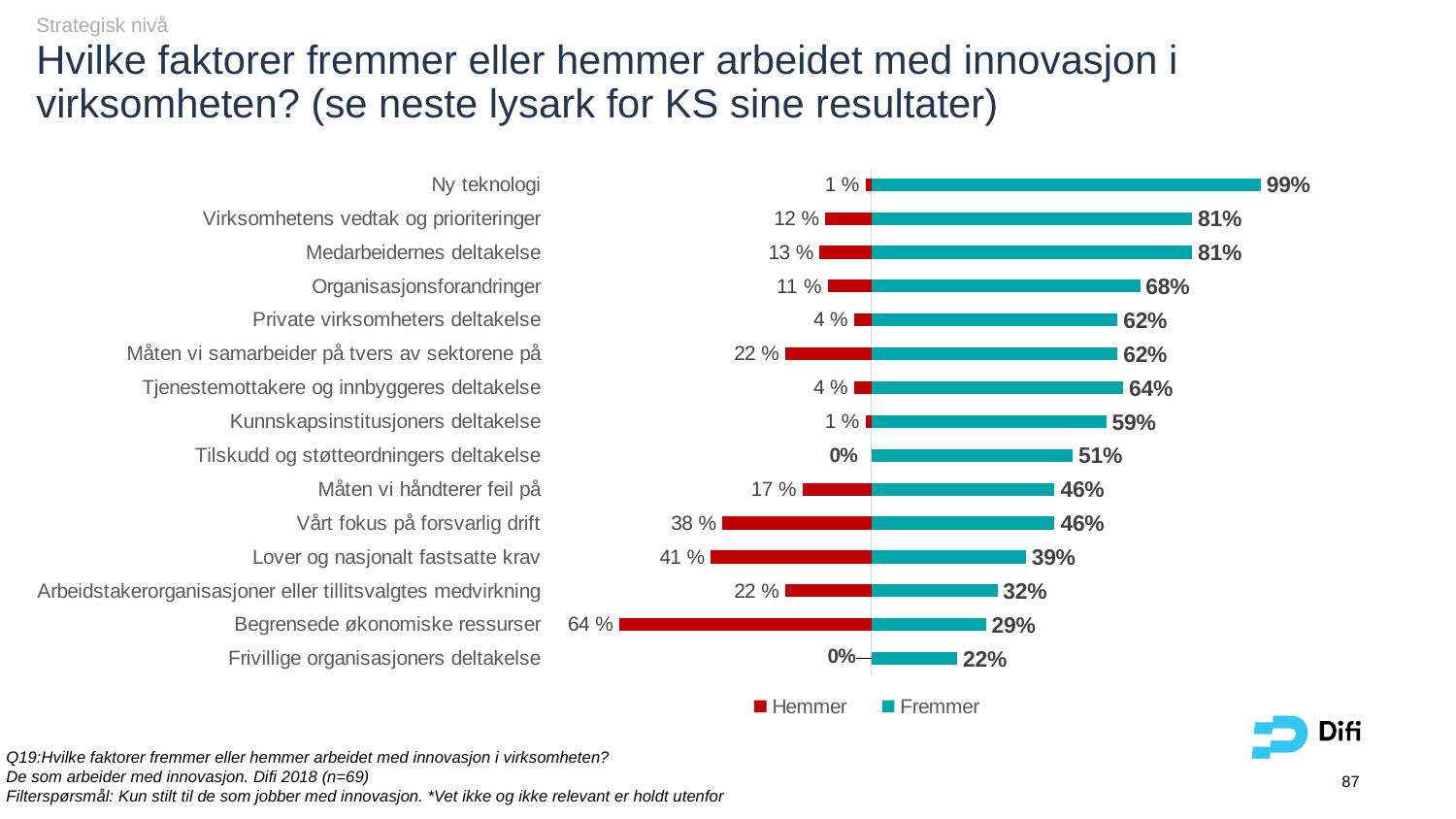
What kind of chart is shown on the slide? Bar chart What is the Hemmer value for Begrensede økonomiske ressurser? 64 % What is the Fremmer value for Ny teknologi? 99% Which category has the highest Hemmer value? Begrensede økonomiske ressurser What is the Fremmer value for Lover og nasjonalt fastsatte krav? 39% How many series does the legend list? 2 Which category has the lowest Fremmer value? Frivillige organisasjoners deltakelse Which category has the highest Fremmer value? Ny teknologi For Lover og nasjonalt fastsatte krav, which is larger: the Hemmer value or the Fremmer value? Hemmer How many categories are shown in the chart? 15 What is the Hemmer value for Vårt fokus på forsvarlig drift? 38 % What is the difference between the Fremmer values for Ny teknologi and Organisasjonsforandringer? 31 percentage points